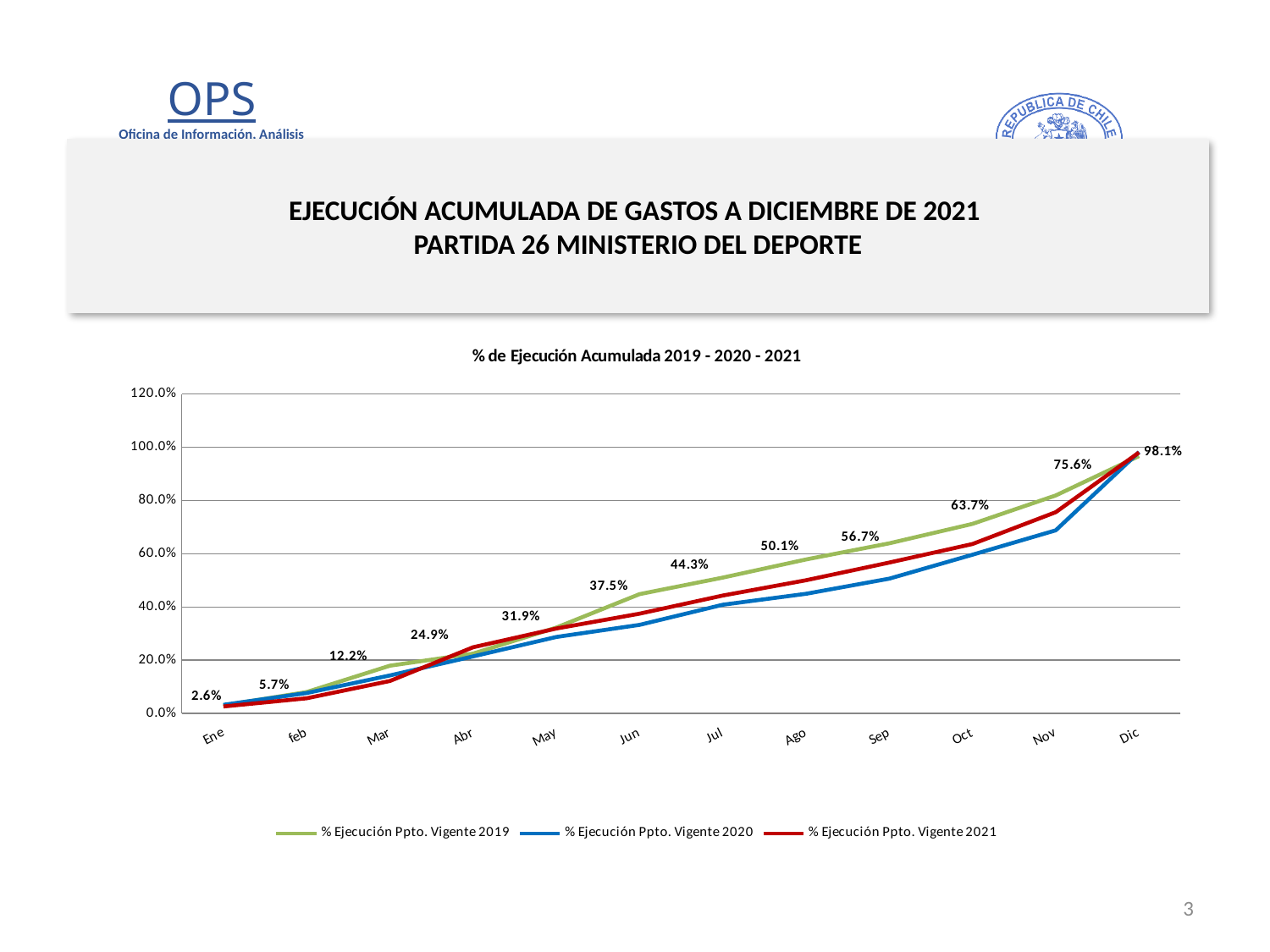
What is the data label shown at Ene? 2.6% How many series does the legend list? 3 What is the data label shown at Dic? 98.1% What is the data label shown at Nov? 75.6% How many months are shown along the x axis? 12 Is the value for % Ejecución Ppto. Vigente 2020 at Nov greater or less than 80.0%? less Do the values rise or fall from Ene to Dic? rise What is the title of the chart? % de Ejecución Acumulada 2019 - 2020 - 2021 What is the data label shown at Jul? 44.3% What kind of chart is shown on the slide? line chart Which month has the lowest labelled value? Ene Which month has the highest labelled value? Dic